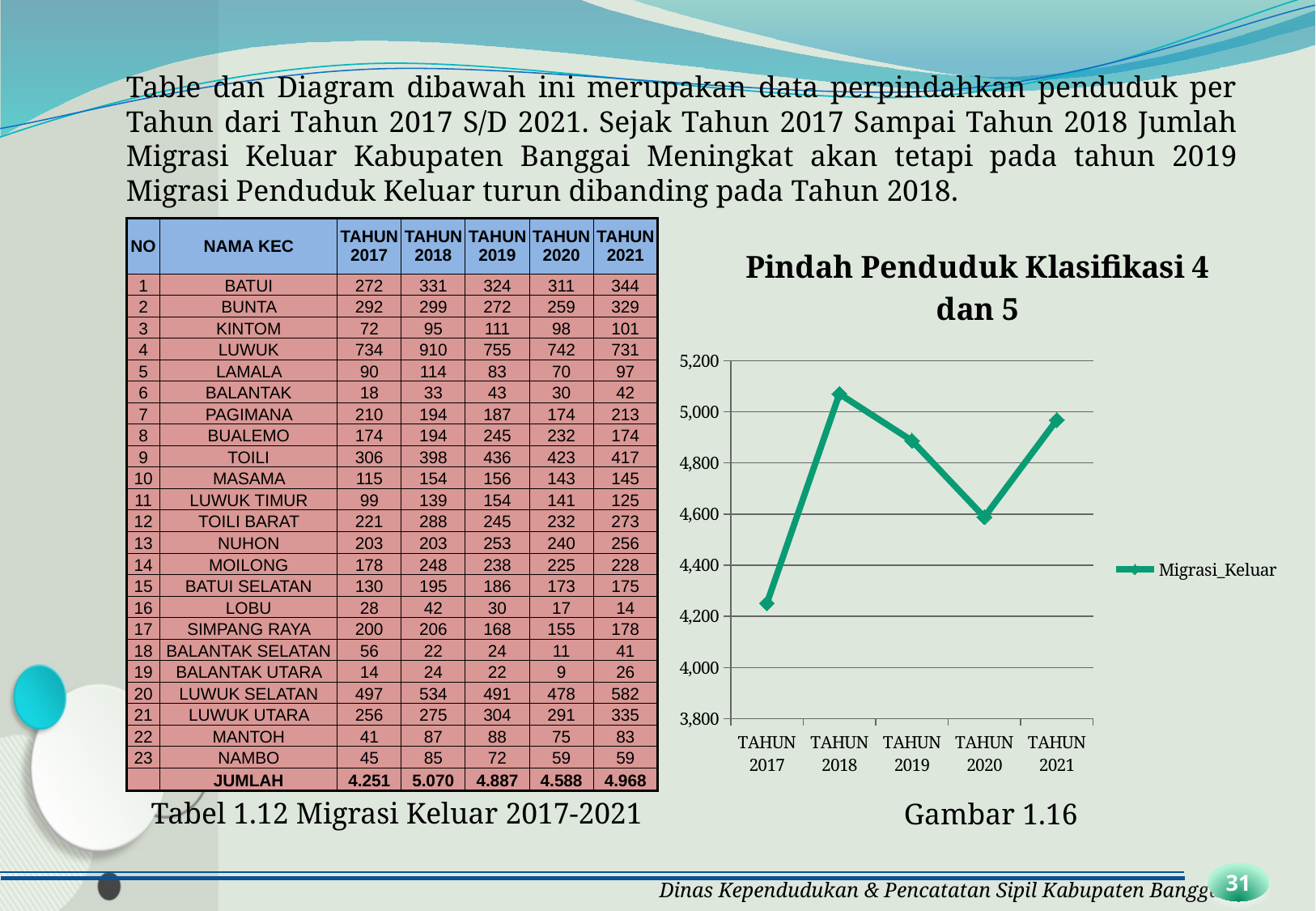
How many data points are plotted on the Migrasi_Keluar line? 5 Is the value for TAHUN 2018 greater or less than 5,000? greater Which year has the highest value on the Migrasi_Keluar line? TAHUN 2018 Which year has the lowest value on the Migrasi_Keluar line? TAHUN 2017 What kind of chart is shown under the title 'Pindah Penduduk Klasifikasi 4 dan 5'? line chart What is the name of the series shown in the chart legend? Migrasi_Keluar Is the value for TAHUN 2017 greater or less than 4,400? less Is the value for TAHUN 2021 greater or less than 4,800? greater How many series does the legend of the chart list? 1 Which is larger on the chart, the value for TAHUN 2018 or TAHUN 2021? TAHUN 2018 Does the Migrasi_Keluar line rise or fall from TAHUN 2018 to TAHUN 2020? fall